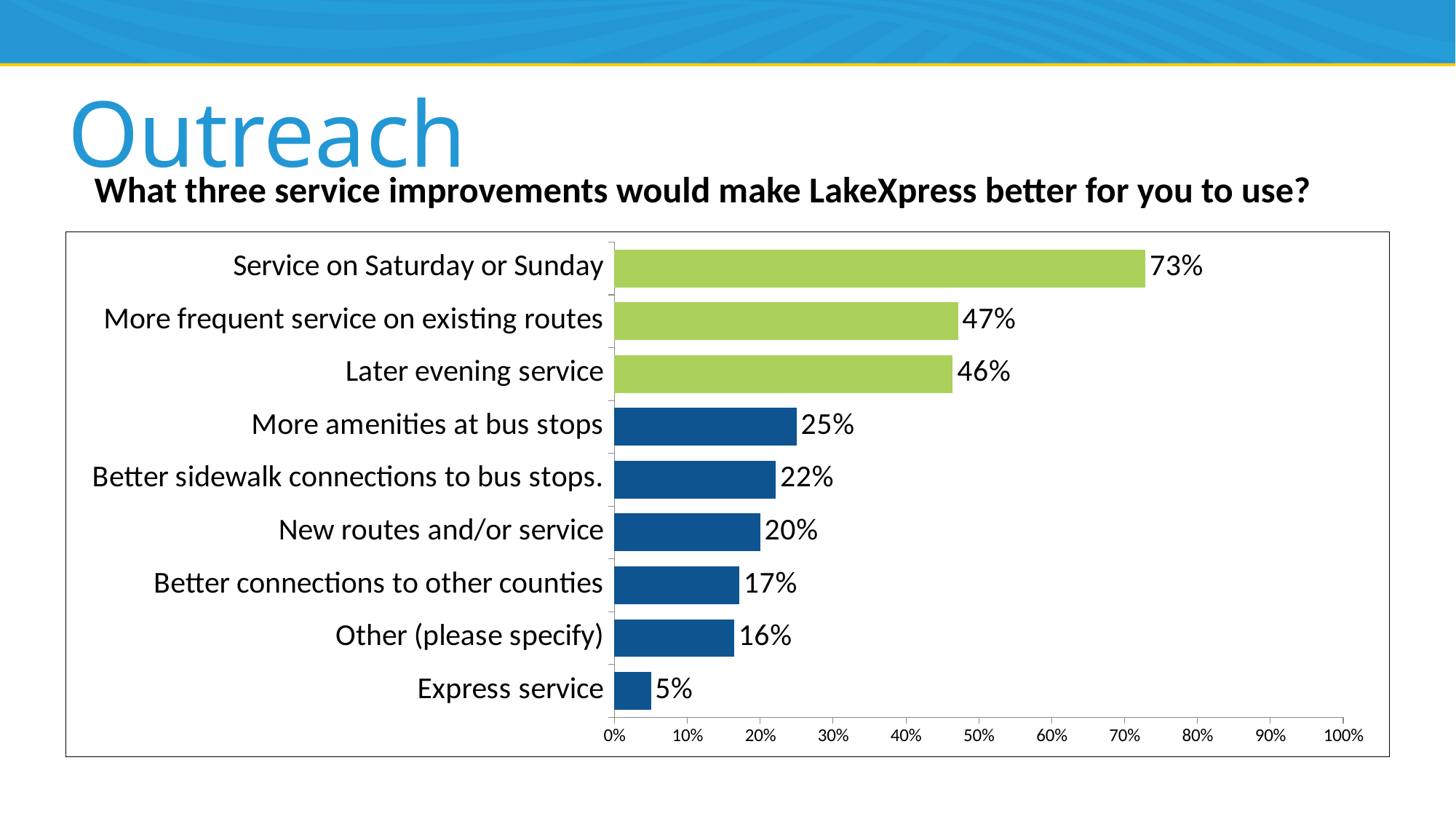
What kind of chart is shown on the slide? Bar chart Which is larger: "New routes and/or service" or "Better connections to other counties"? New routes and/or service What is the difference between "Service on Saturday or Sunday" and "More frequent service on existing routes"? 26% Is the value for "More frequent service on existing routes" greater or less than 40%? greater What is the value for "Later evening service"? 46% Which service improvement has the lowest percentage? Express service What percentage of respondents chose "Service on Saturday or Sunday"? 73% Which service improvement has the highest percentage? Service on Saturday or Sunday How many service improvement categories are shown in the chart? 9 What is the value for "Better sidewalk connections to bus stops."? 22% How many bars are coloured green? 3 What is the difference between "More amenities at bus stops" and "Express service"? 20%